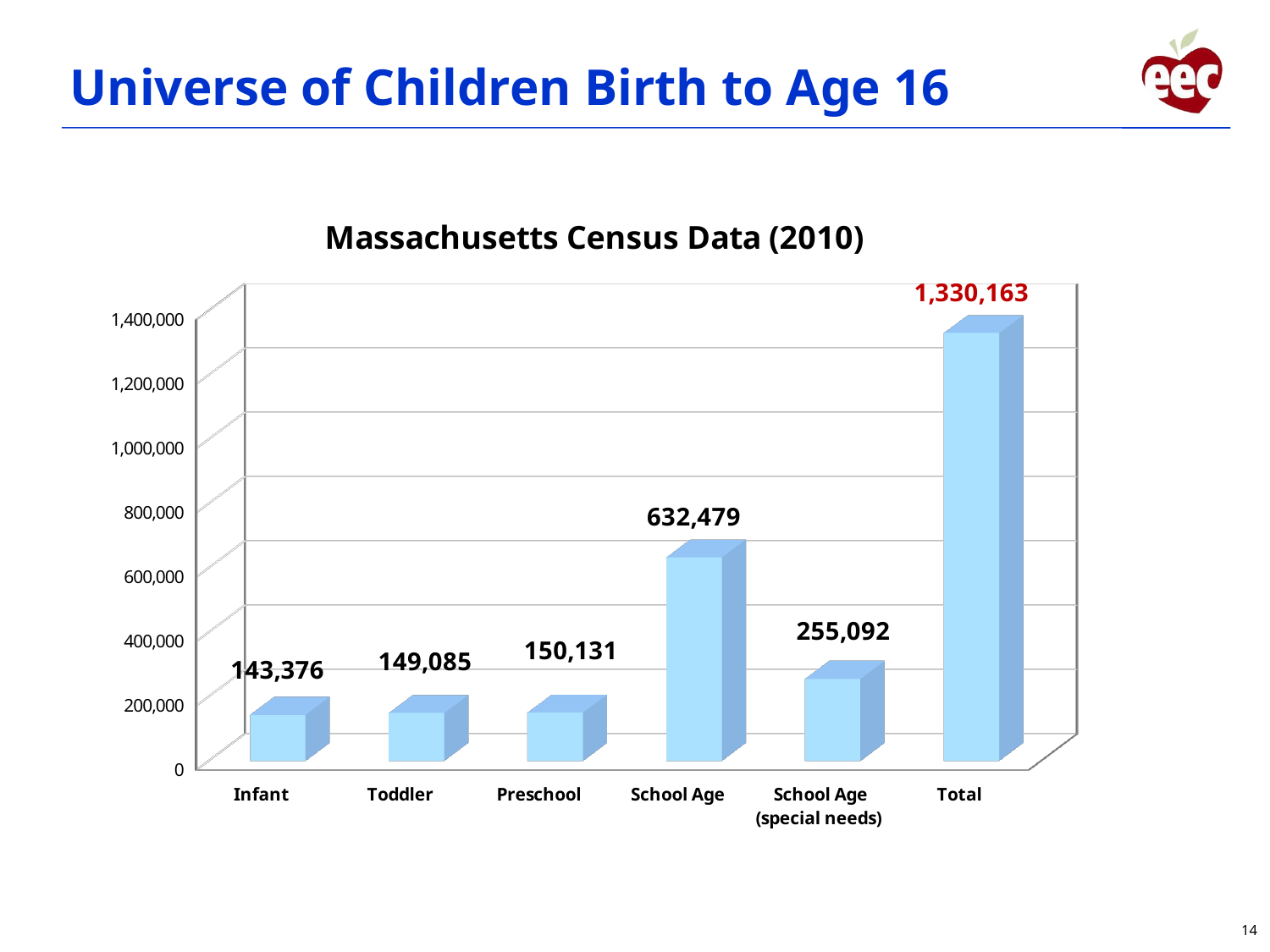
What is the value for Infant? 143,376 What is the title of the chart? Massachusetts Census Data (2010) How many categories are shown on the x axis? 6 Which is larger, the value for School Age (special needs) or the value for Preschool? School Age (special needs) What is the value for School Age? 632,479 Which category has the highest value? Total What is the difference between the Preschool value and the Toddler value? 1,046 What is the value for School Age (special needs)? 255,092 What is the value for Total? 1,330,163 Which category has the lowest value? Infant What kind of chart is shown on the slide? Bar chart What is the difference between the School Age value and the School Age (special needs) value? 377,387